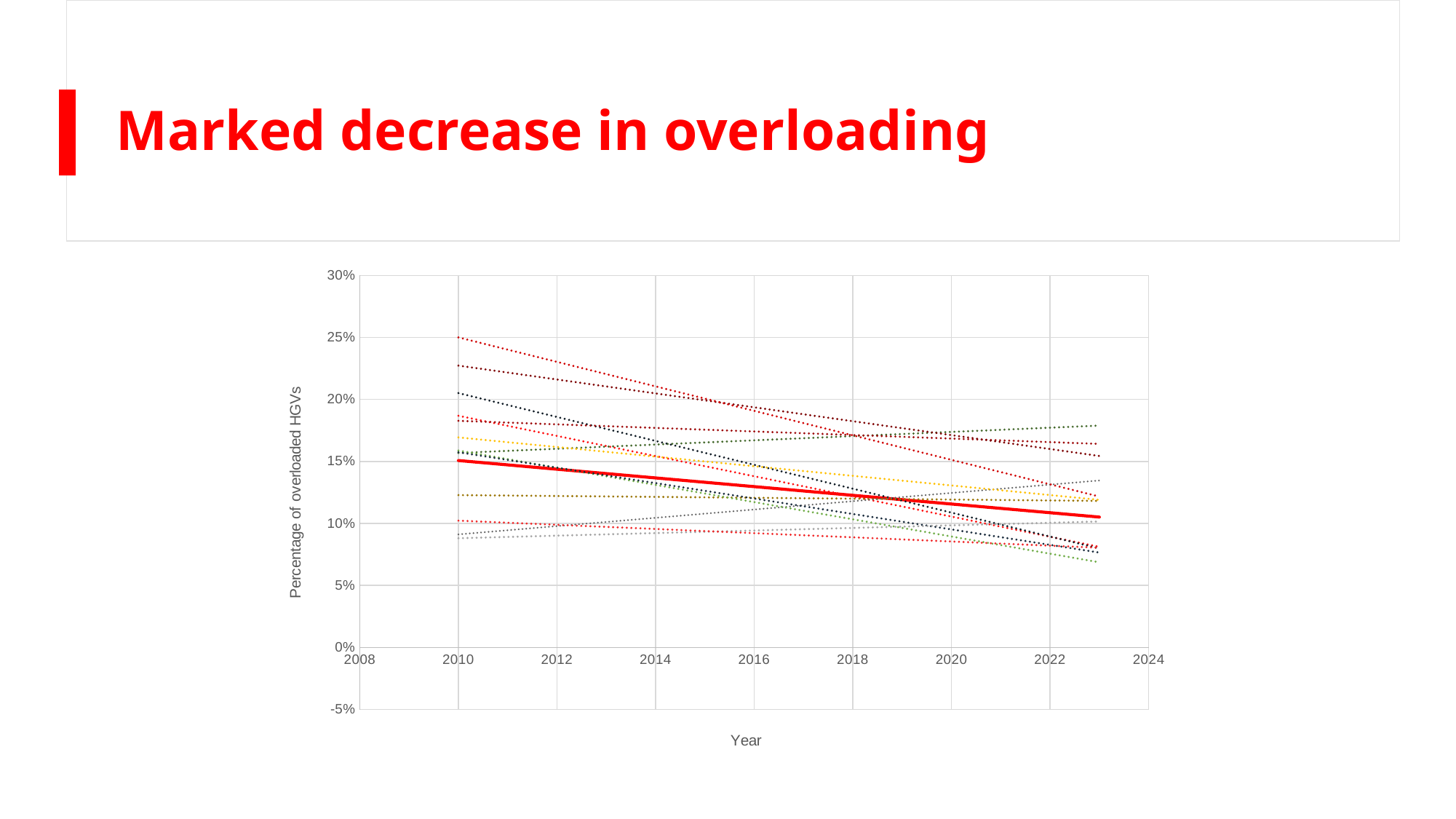
Is the lowest dotted line's value in 2023 greater or less than 10%? less What is the label on the vertical axis of the chart? Percentage of overloaded HGVs Is the highest dotted line's value in 2010 greater or less than 20%? greater Is the value of the solid red line in 2023 greater or less than 15%? less What kind of chart is shown on the slide? line chart What is the label on the horizontal axis of the chart? Year For the solid red line, which year has the larger value, 2010 or 2023? 2010 Does the solid red line rise or fall from 2010 to 2023? fall